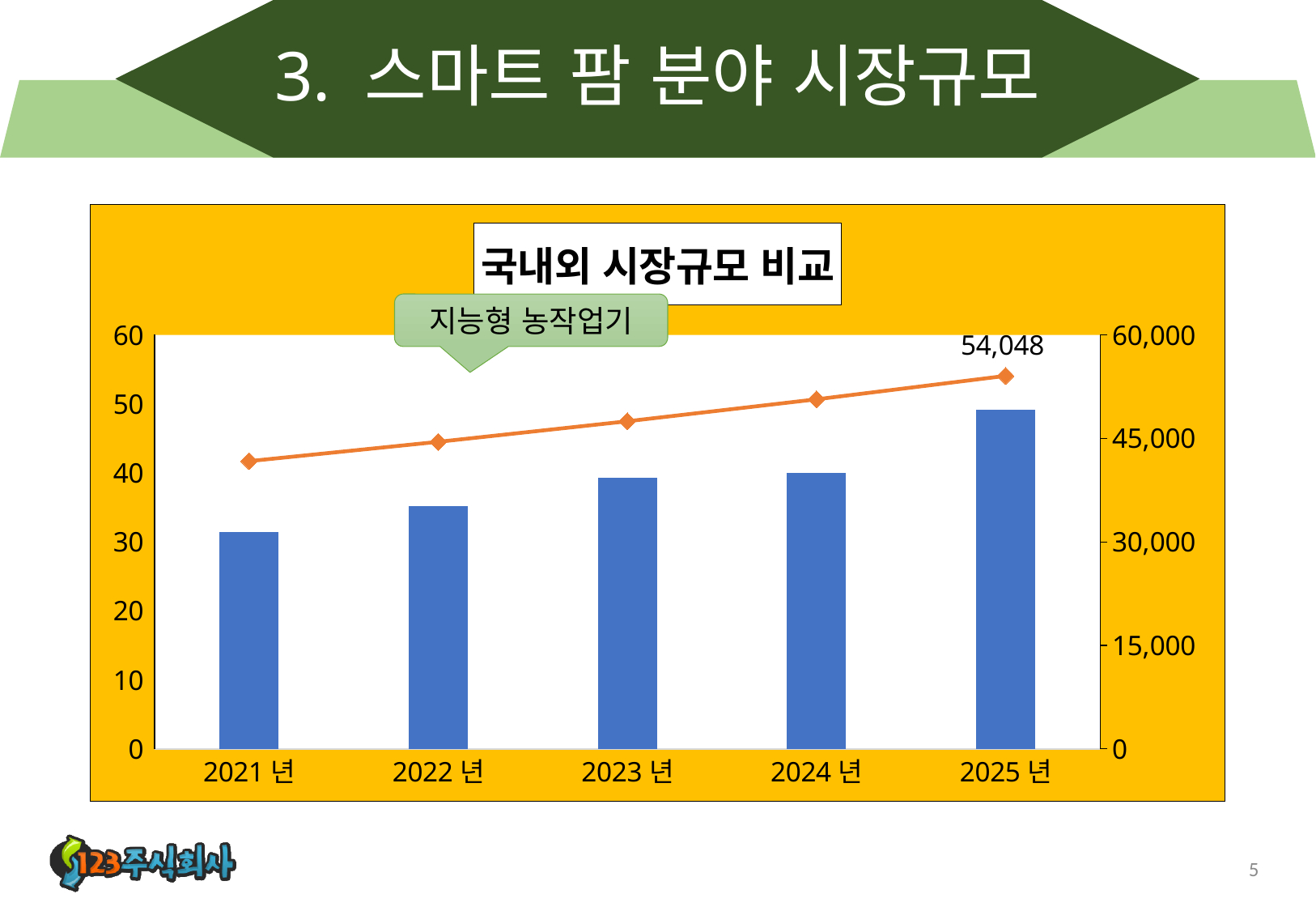
Which bar is taller, 2021 년 or 2025 년? 2025 년 Is the line value for 2021 년 greater or less than 45,000 on the right axis? less What label does the callout pointing to the line series show? 지능형 농작업기 What kind of chart is this? A bar chart combined with a line chart Do the bar values rise or fall from 2021 년 to 2025 년? Rise How many years are shown on the x axis? 5 Which year has the shortest bar? 2021 년 What is the data label shown on the line series at 2025 년? 54,048 Which year has the tallest bar? 2025 년 Is the bar value for 2021 년 greater or less than 40 on the left axis? less Is the bar value for 2025 년 greater or less than 40 on the left axis? greater What is the title of the chart? 국내외 시장규모 비교